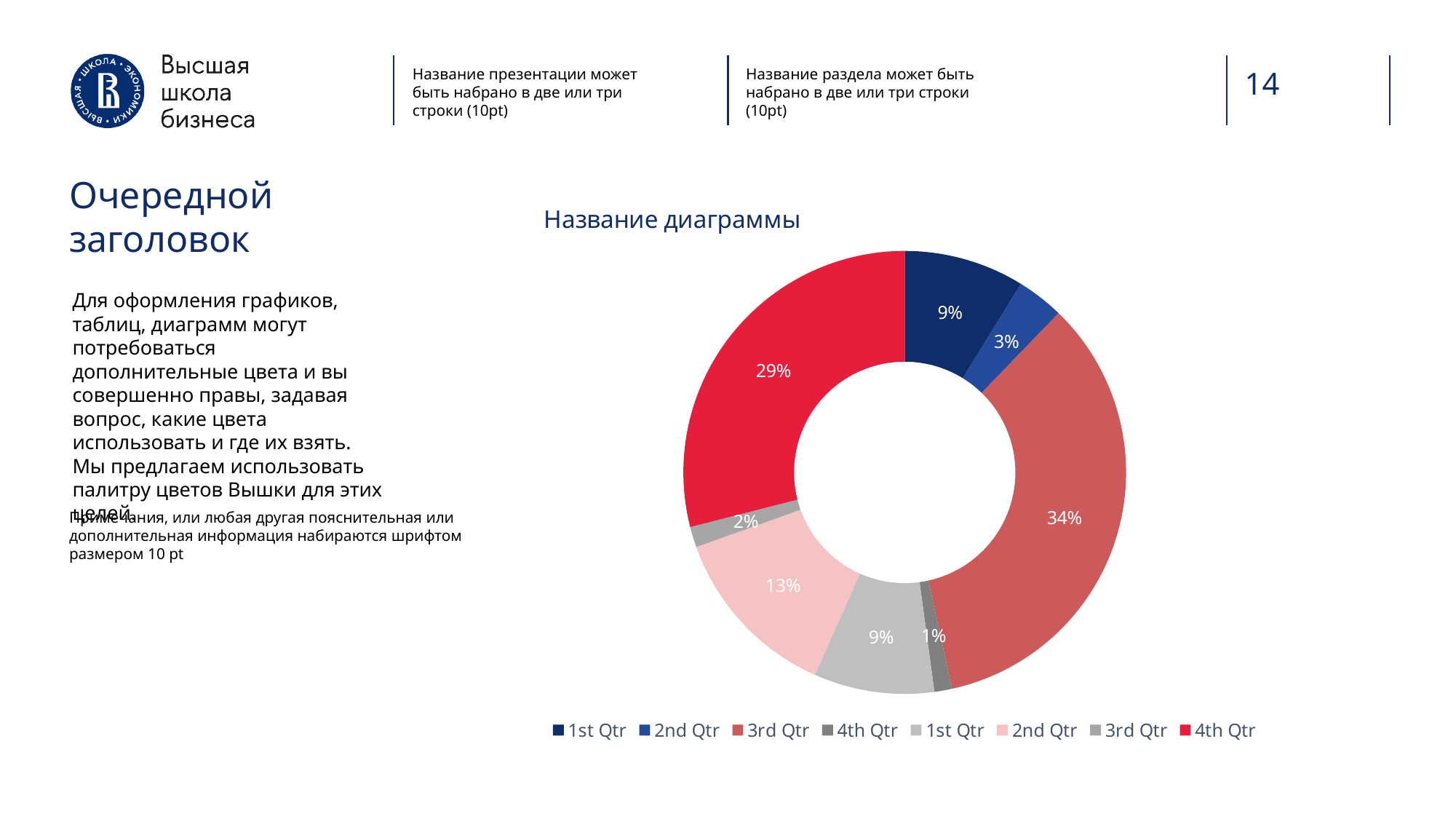
What is the value of the smallest slice in the chart? 1% How many slices does the doughnut chart have? 8 Which is larger: the light pink slice or the light grey slice? the light pink slice (13%) What is the value of the light pink slice (the second 2nd Qtr entry in the legend)? 13% What is the difference between the largest slice (34%) and the bright red slice (29%)? 5 percentage points What is the title of the chart? Название диаграммы What kind of chart is shown on the slide? doughnut chart How many entries does the chart legend list? 8 What is the difference between the light pink slice (13%) and the blue slice (3%)? 10 percentage points What is the value of the largest slice in the chart? 34% What is the value of the bright red slice (the last 4th Qtr entry in the legend)? 29% What is the value of the dark navy slice (the first 1st Qtr entry in the legend)? 9%